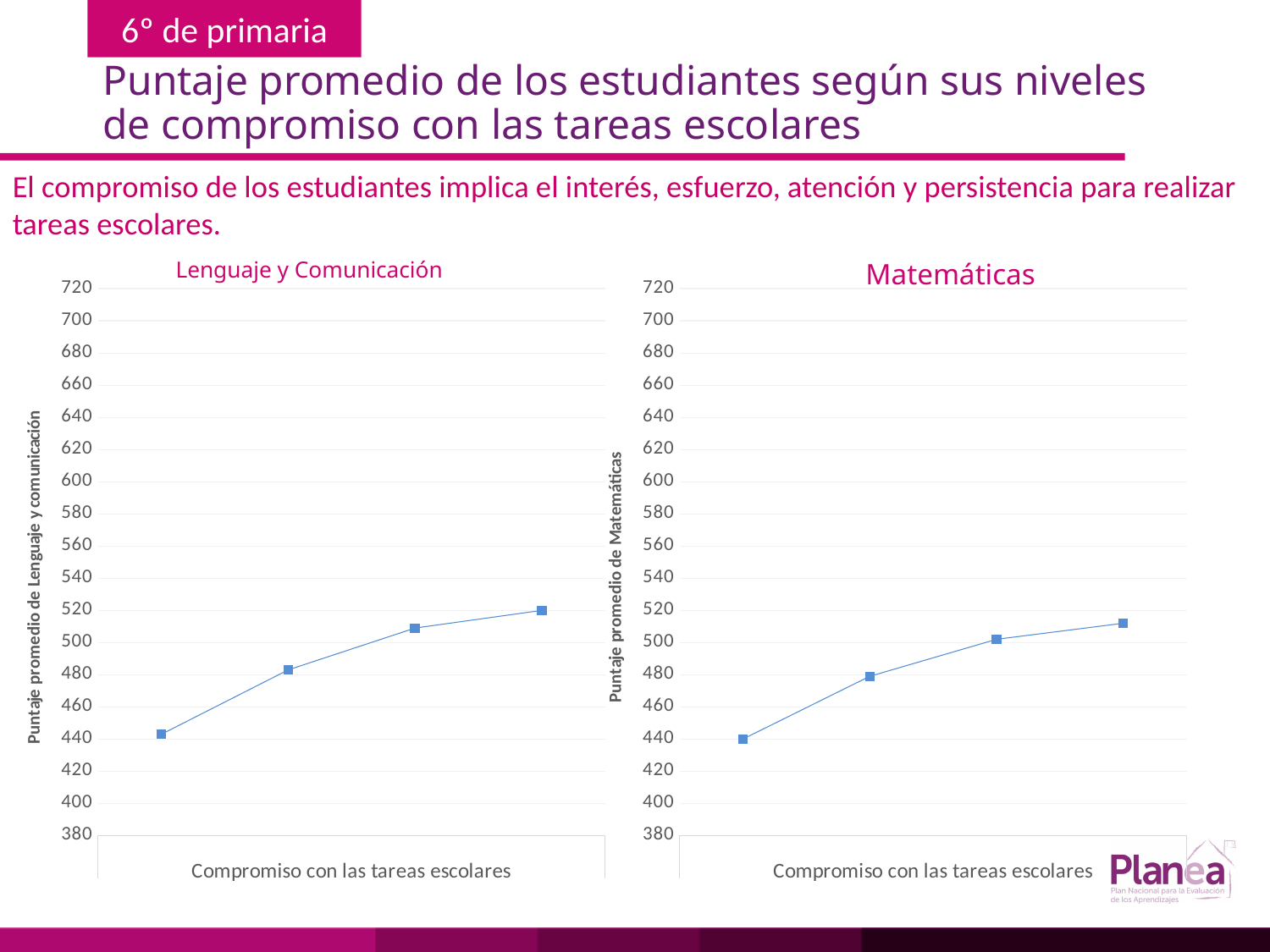
In the 'Matemáticas' chart, which point has the highest value: the leftmost or the rightmost? the rightmost In the 'Lenguaje y Comunicación' chart, is the value of the leftmost point greater or less than 460? less In the 'Matemáticas' chart, is the value of the leftmost point greater or less than 460? less How many data points are plotted in the 'Matemáticas' chart? 4 In the 'Matemáticas' chart, do the values rise or fall from left to right along the x axis? rise What is the y-axis label of the left chart? Puntaje promedio de Lenguaje y comunicación In the 'Lenguaje y Comunicación' chart, is the value of the rightmost point greater or less than 500? greater What kind of chart is the 'Lenguaje y Comunicación' chart? line chart In the 'Lenguaje y Comunicación' chart, do the values rise or fall from left to right along the x axis? rise What is the x-axis label of the 'Matemáticas' chart? Compromiso con las tareas escolares In the 'Lenguaje y Comunicación' chart, which point has the lowest value: the leftmost or the rightmost? the leftmost